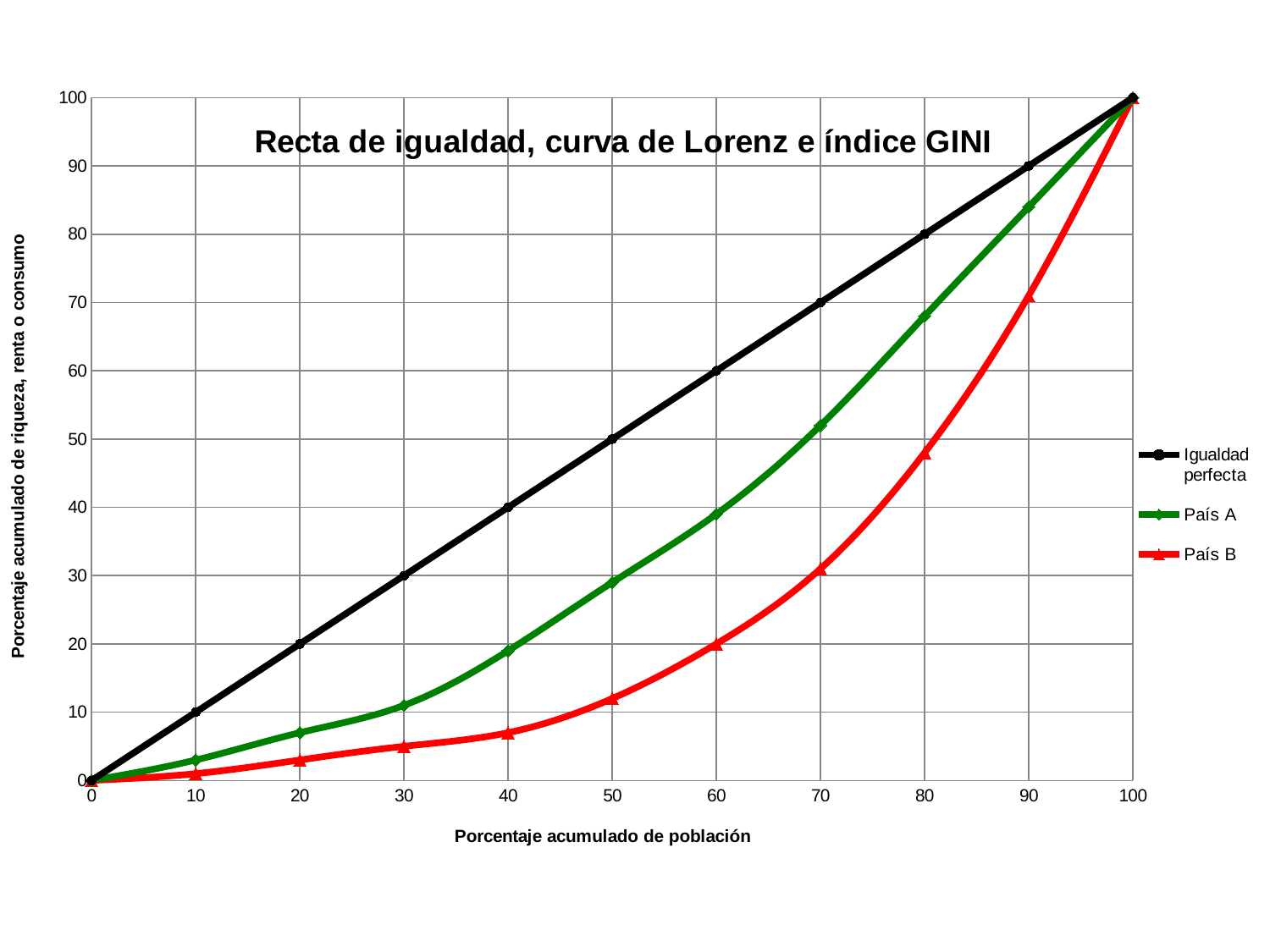
Is the value for País B at 50 on the x axis greater or less than 20? less At 70 on the x axis, which series has the larger value, País A or País B? País A Which series has the highest value at 40 on the x axis? Igualdad perfecta What is the value of the Igualdad perfecta series at 80 on the x axis? 80 Is the value for País B at 70 on the x axis greater or less than 40? less Is the value for País A at 60 on the x axis greater or less than 30? greater What is the title of the chart? Recta de igualdad, curva de Lorenz e índice GINI What is the value of the Igualdad perfecta series at 50 on the x axis? 50 Do the values of the País B series rise or fall as the x axis increases? rise How many series does the legend list? 3 What kind of chart is shown on the slide? line chart